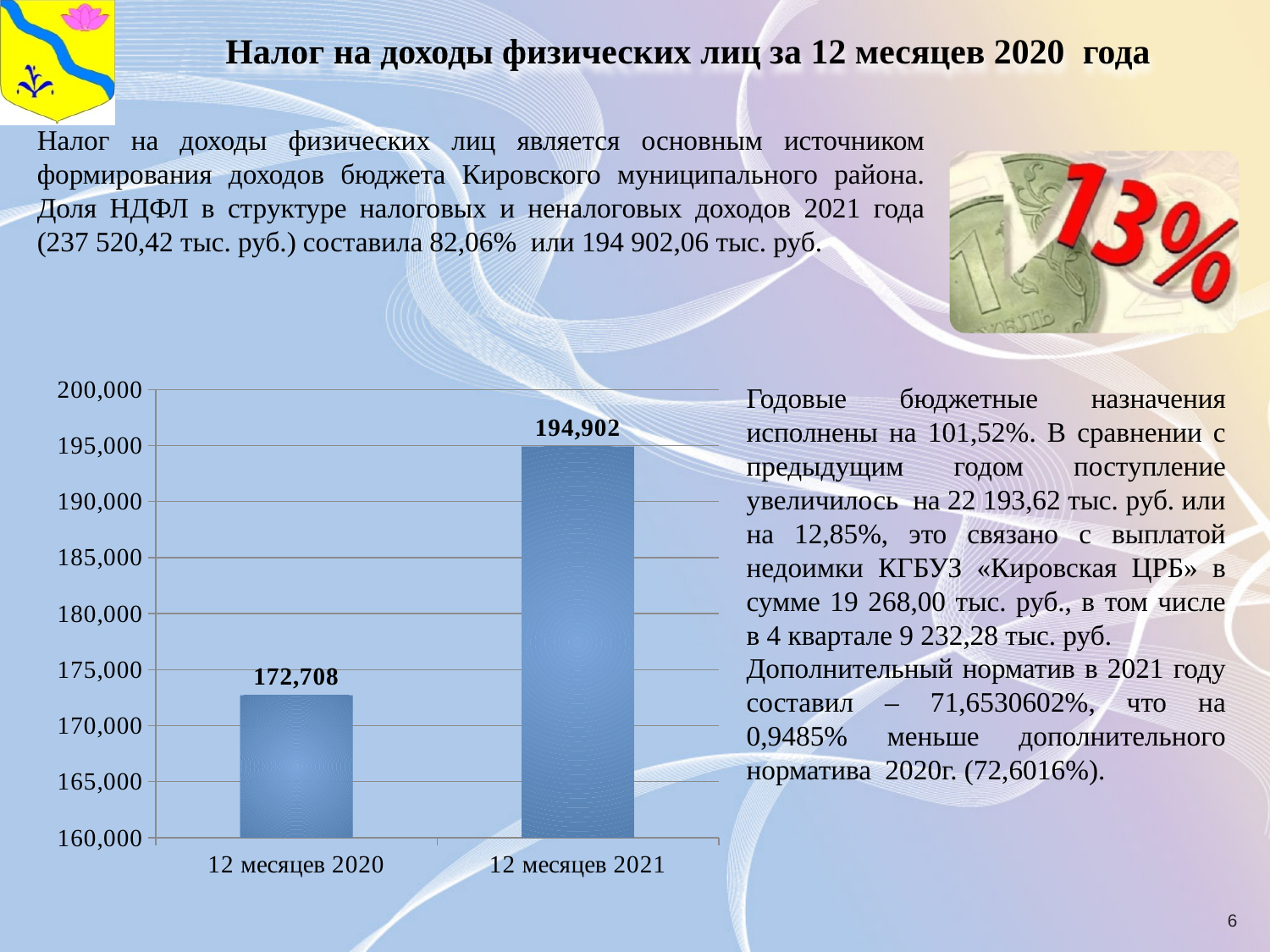
Do the values rise or fall from 12 месяцев 2020 to 12 месяцев 2021? rise What kind of chart is shown on the slide? bar chart Is the value for 12 месяцев 2020 greater or less than 175,000? less Which is larger, the value for 12 месяцев 2020 or for 12 месяцев 2021? 12 месяцев 2021 What is the value for 12 месяцев 2021? 194,902 Which category has the lowest value? 12 месяцев 2020 What is the difference between the values for 12 месяцев 2021 and 12 месяцев 2020? 22,194 What is the value for 12 месяцев 2020? 172,708 How many categories are shown on the chart? 2 What is the lowest value shown on the vertical axis of the chart? 160,000 Is the value for 12 месяцев 2021 greater or less than 190,000? greater Which category has the highest value? 12 месяцев 2021